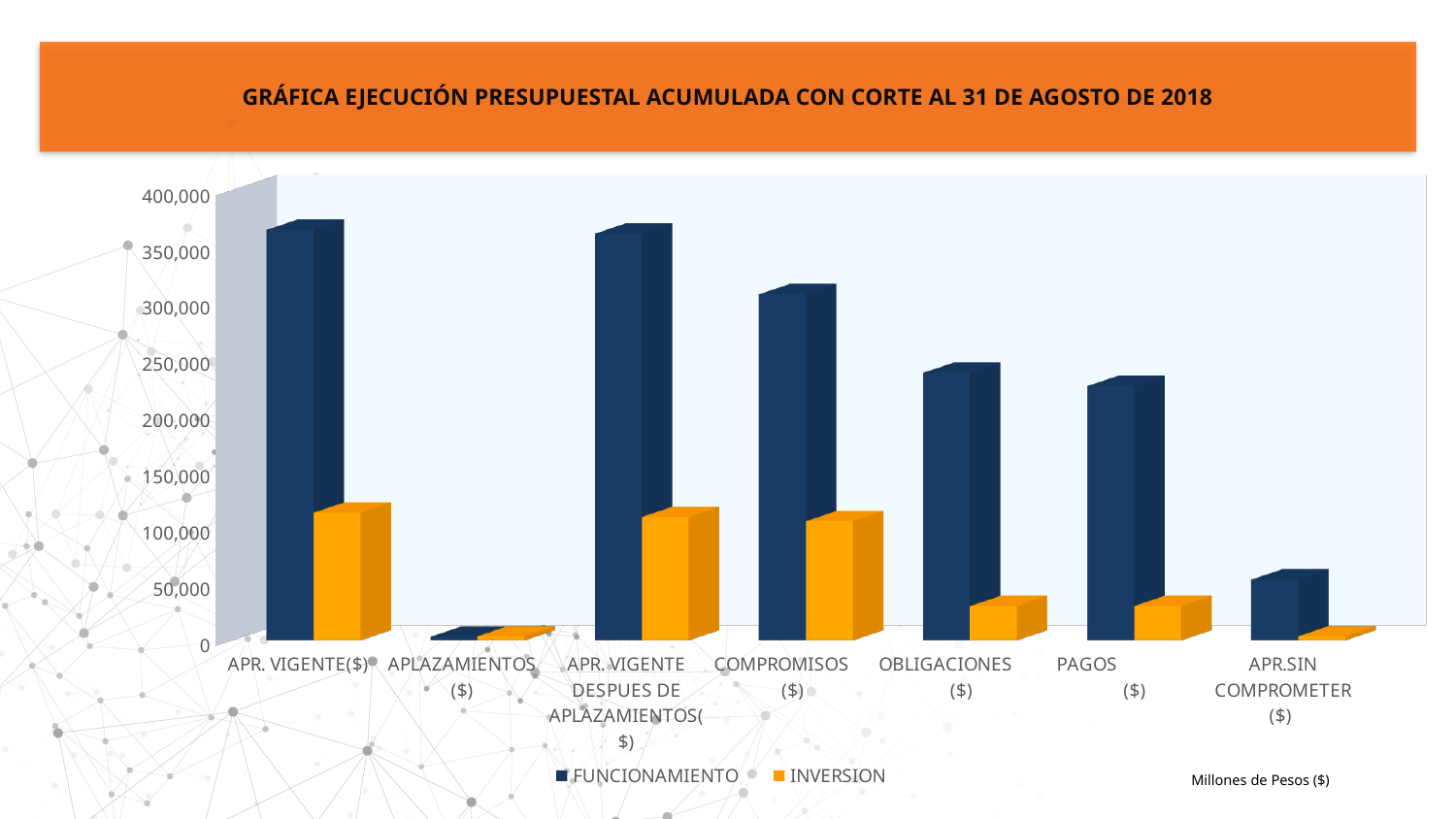
Which series is shown in orange? INVERSION Is the FUNCIONAMIENTO value for COMPROMISOS ($) greater or less than 250,000? greater How many categories are shown along the x axis? 7 Is the FUNCIONAMIENTO value for APR.SIN COMPROMETER ($) greater or less than 100,000? less How many series does the legend list? 2 Is the INVERSION value for OBLIGACIONES ($) greater or less than 50,000? less What kind of chart is shown on the slide? bar chart What is the title of the chart? GRÁFICA EJECUCIÓN PRESUPUESTAL ACUMULADA CON CORTE AL 31 DE AGOSTO DE 2018 Which is larger, the FUNCIONAMIENTO value for COMPROMISOS ($) or for OBLIGACIONES ($)? COMPROMISOS ($) Which is larger for PAGOS ($), the FUNCIONAMIENTO value or the INVERSION value? FUNCIONAMIENTO Which category has the lowest FUNCIONAMIENTO value? APLAZAMIENTOS ($)